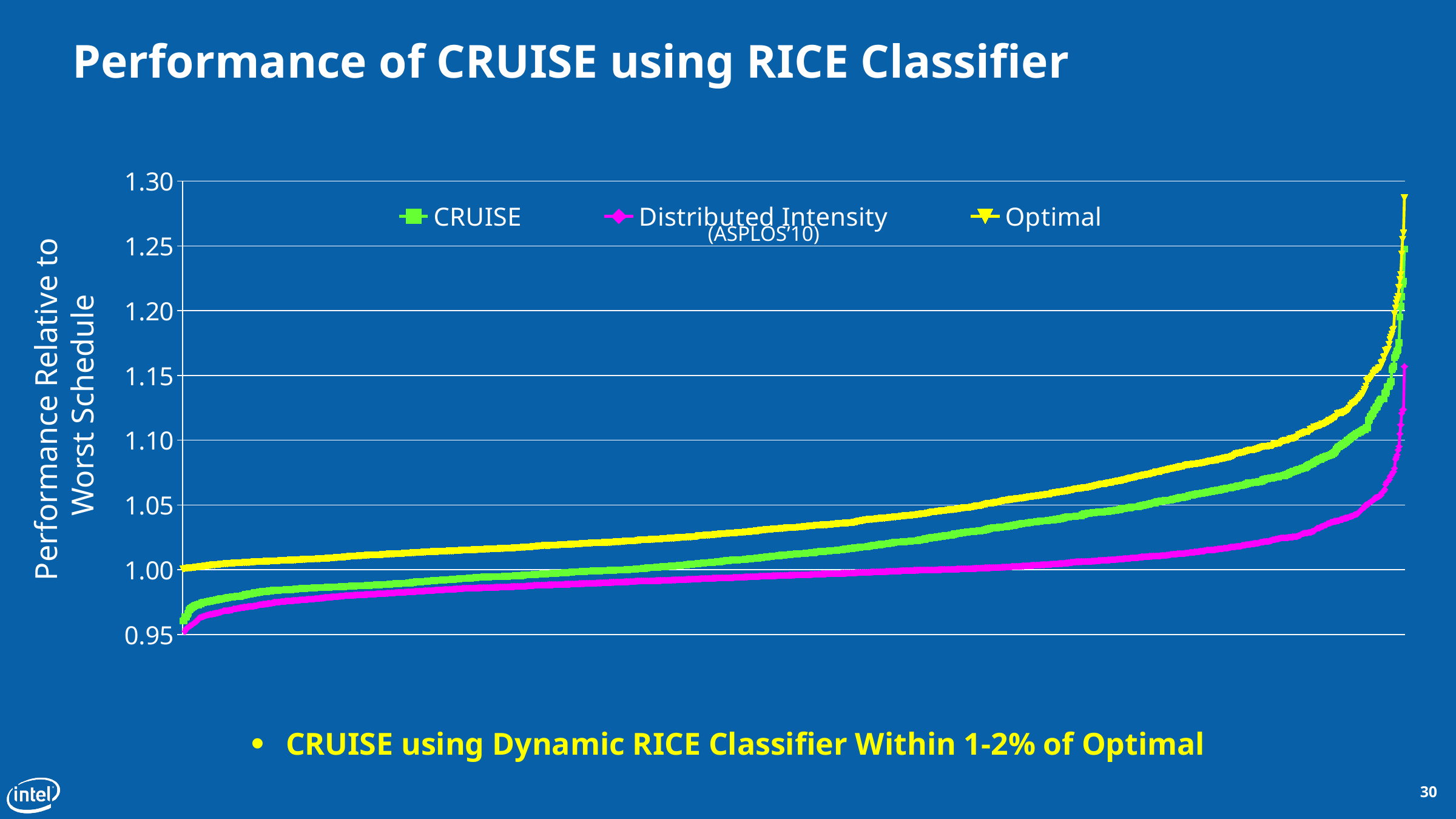
Which series has the lowest values across the chart? Distributed Intensity Which series is higher at the right end of the chart, CRUISE or Distributed Intensity? CRUISE What kind of chart is shown on the slide? Line chart Do the values of the CRUISE series rise or fall along the x axis? Rise What is the title of the chart's y axis? Performance Relative to Worst Schedule Do the values of the Optimal series rise or fall along the x axis? Rise How many series does the legend list? 3 Is the highest value of the Distributed Intensity series greater or less than 1.20? less Is the highest value of the Optimal series greater or less than 1.25? greater Which series has the highest values across the chart? Optimal Is the lowest value of the CRUISE series greater or less than 1.00? less What colour is the Optimal series line? Yellow